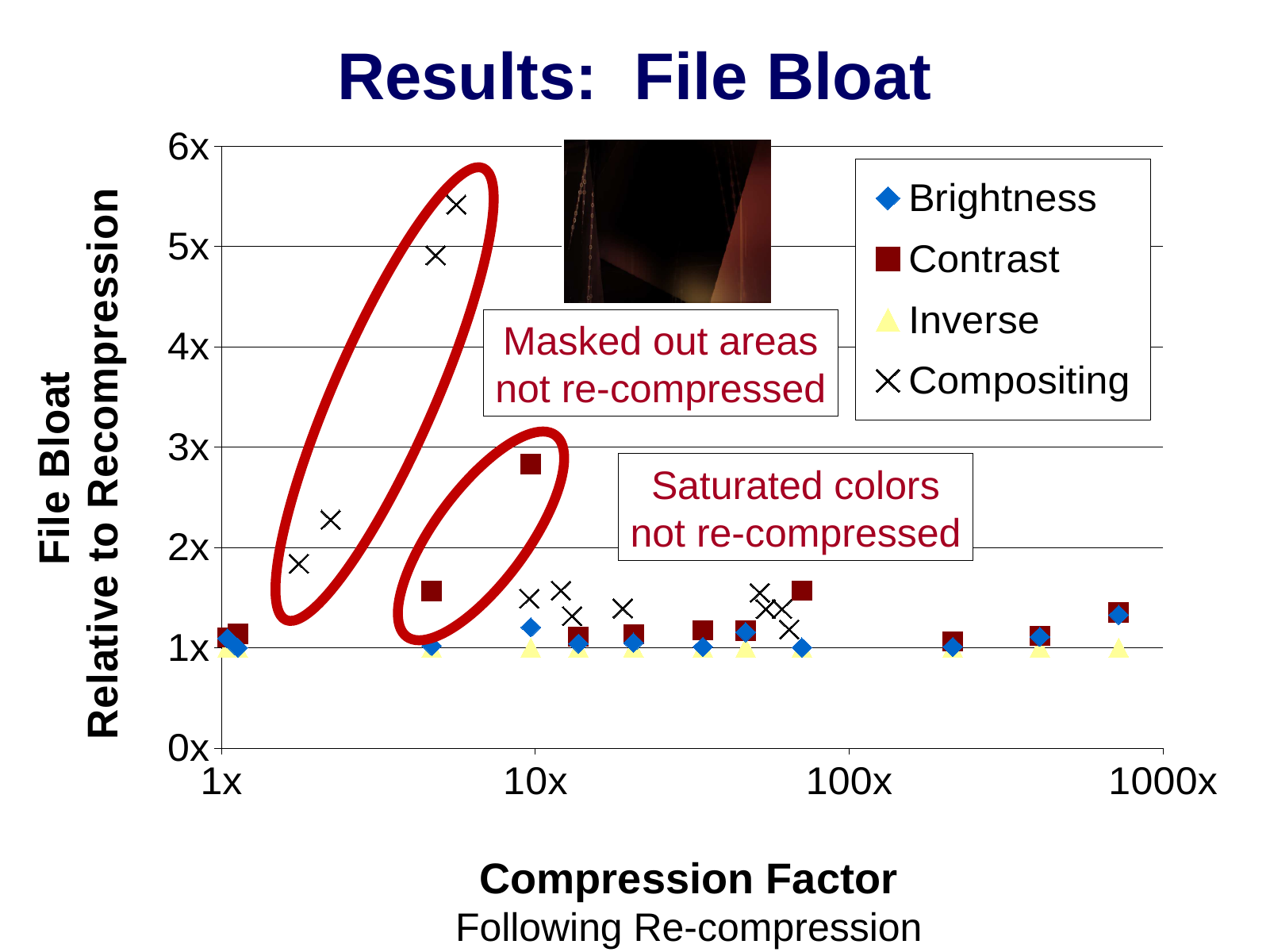
What kind of chart is shown on the slide? scatter chart Are all the Brightness points greater or less than 2x file bloat? less Is the highest Compositing point greater or less than 5x file bloat? greater How many series does the legend list? 4 Which series is plotted with X markers according to the legend? Compositing Which series has the highest plotted file bloat value? Compositing Are all the Inverse points greater or less than 2x file bloat? less What is the title of the chart on the slide? Results: File Bloat Which is larger: the highest Compositing point or the highest Contrast point? the highest Compositing point Which series has the lowest plotted file bloat values overall? Inverse